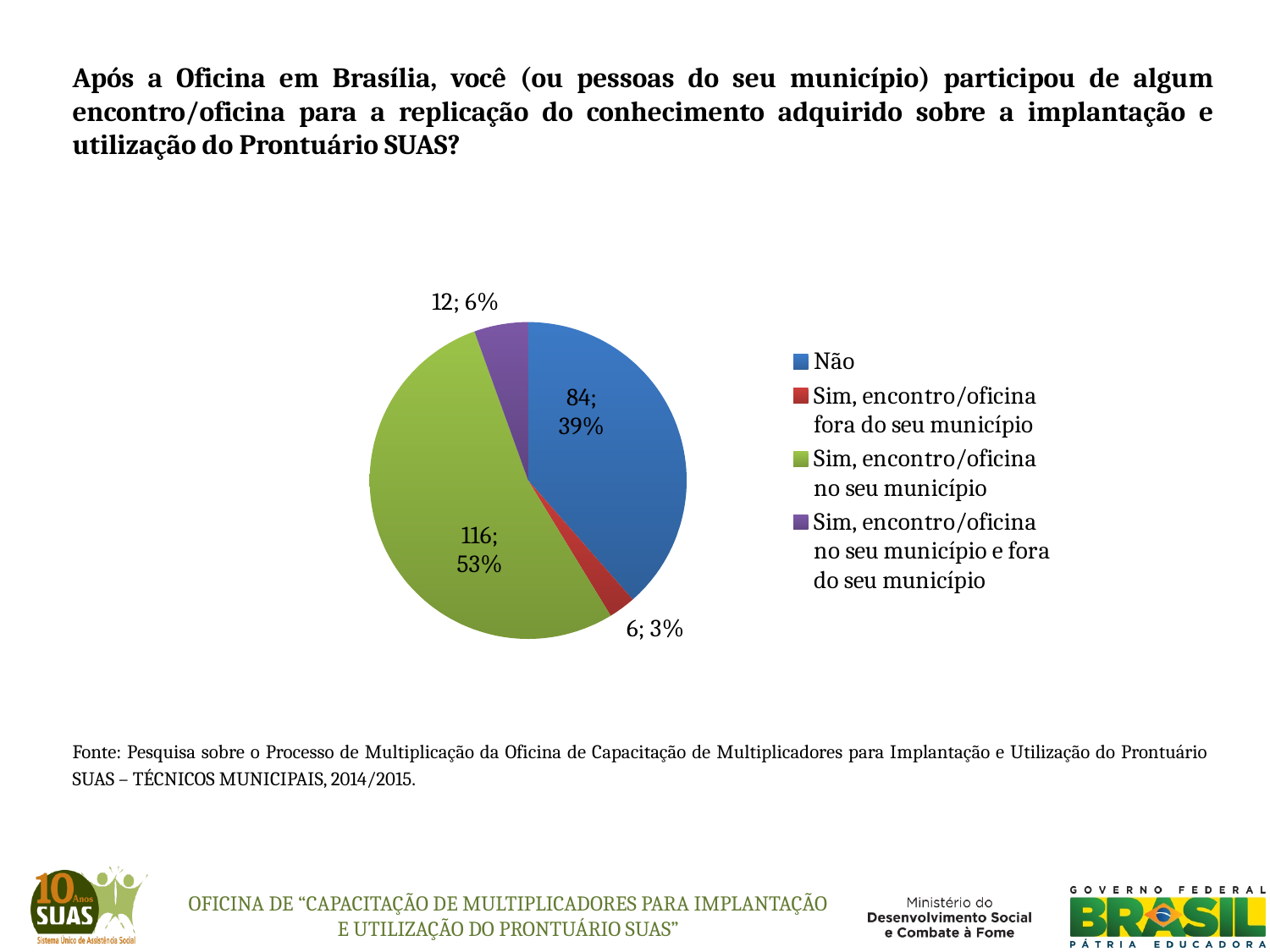
Which category has the largest slice? Sim, encontro/oficina no seu município What percentage of the pie is "Sim, encontro/oficina no seu município e fora do seu município"? 6% Which category has the smallest slice? Sim, encontro/oficina fora do seu município How many slices does the pie chart have? 4 What kind of chart is shown on the slide? pie chart What is the count for "Sim, encontro/oficina fora do seu município"? 6 What percentage of the pie is "Sim, encontro/oficina no seu município"? 53% What is the difference in count between "Sim, encontro/oficina no seu município" and "Não"? 32 How many entries does the legend list? 4 What colour is the slice for "Não"? blue Which is larger: the count for "Não" or the count for "Sim, encontro/oficina no seu município e fora do seu município"? Não What is the count for "Não"? 84